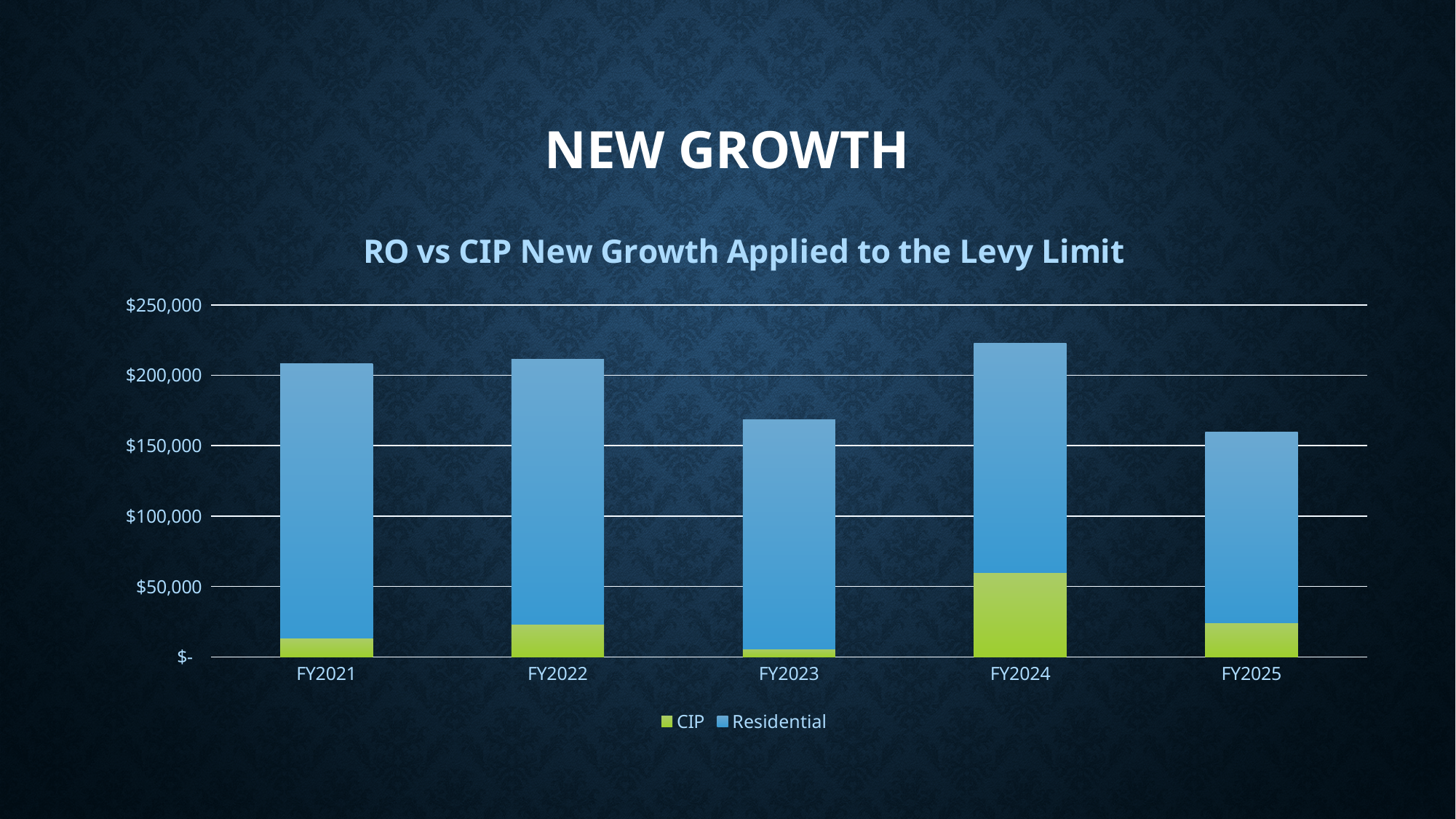
Is the CIP value for FY2021 greater or less than $50,000? less Which fiscal year has the smallest CIP segment? FY2023 How many series does the chart's legend list? 2 What is the title of the chart? RO vs CIP New Growth Applied to the Levy Limit What kind of chart is shown on the slide? Stacked bar chart Is the total stacked bar for FY2025 greater or less than $200,000? less How many fiscal years are shown on the x axis of the chart? 5 Which fiscal year has the tallest stacked bar (highest total new growth)? FY2024 Which has the larger total stacked bar, FY2021 or FY2023? FY2021 Which fiscal year has the largest CIP segment? FY2024 Is the total stacked bar for FY2024 greater or less than $200,000? greater